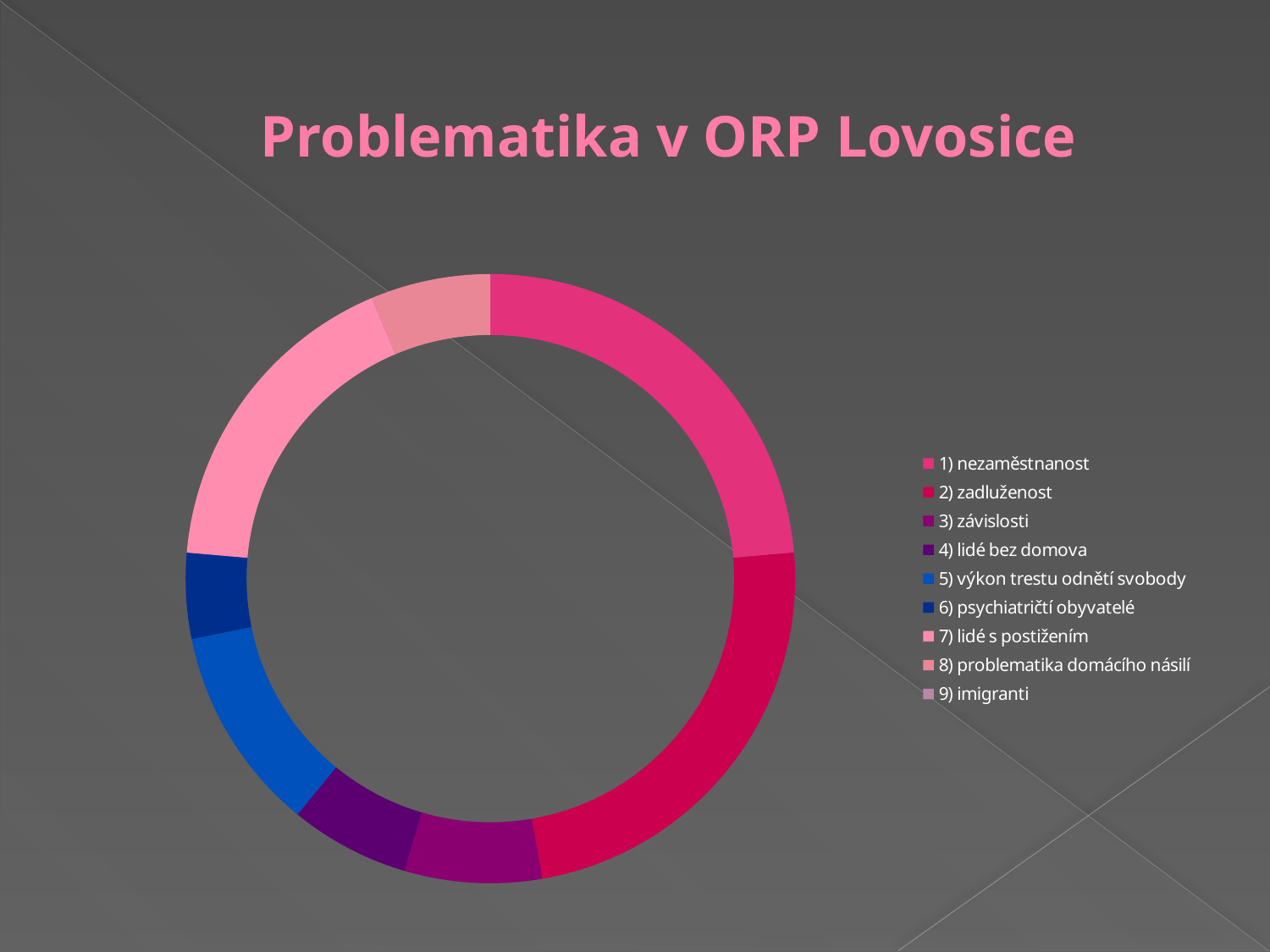
What is the title of the chart slide? Problematika v ORP Lovosice Which is larger, the share for 7) lidé s postižením or the share for 8) problematika domácího násilí? 7) lidé s postižením Which is larger, the share for 5) výkon trestu odnětí svobody or the share for 6) psychiatričtí obyvatelé? 5) výkon trestu odnětí svobody Which is larger, the share for 1) nezaměstnanost or the share for 4) lidé bez domova? 1) nezaměstnanost What kind of chart is shown on the slide? Doughnut (pie) chart How many categories does the chart legend list? 9 What is the last category listed in the chart legend? 9) imigranti